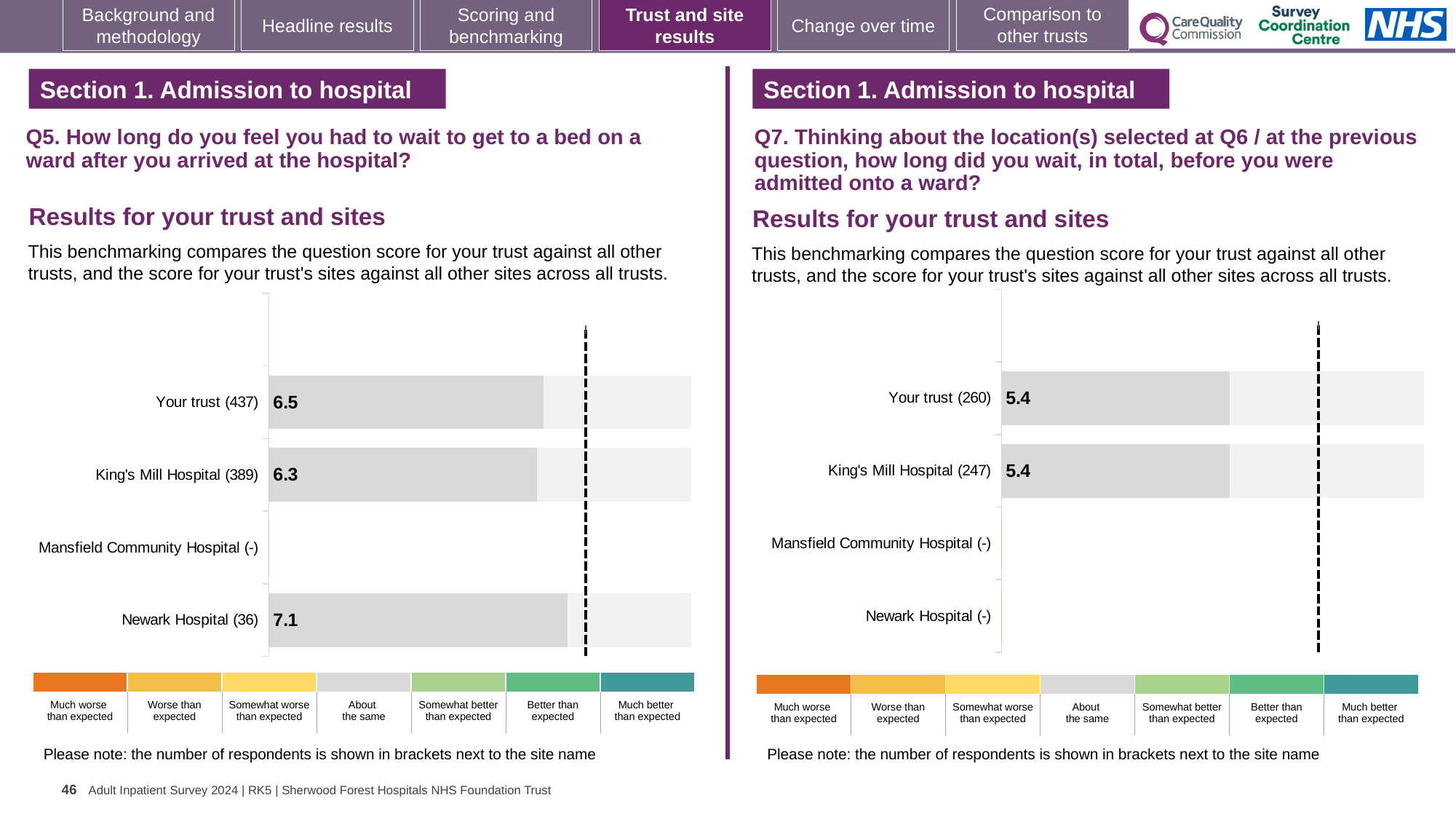
In the Q7 chart on the right, what is the score for King's Mill Hospital? 5.4 How many site/trust rows are listed in the Q7 chart on the right? 4 In the Q5 chart on the left, what is the score for Newark Hospital? 7.1 In the Q5 chart on the left, what is the difference between the Newark Hospital score and the King's Mill Hospital score? 0.8 In the Q5 chart on the left, how many respondents are shown for Newark Hospital? 36 What type of chart is used in the Q5 chart on the left? Bar chart In the Q5 chart on the left, which is larger: the score for Your trust or the score for King's Mill Hospital? Your trust In the Q7 chart on the right, what is the score for Your trust? 5.4 In the Q5 chart on the left, what is the score for King's Mill Hospital? 6.3 In the Q7 chart on the right, how many respondents are shown for King's Mill Hospital? 247 In the Q5 chart on the left, which site has the highest score? Newark Hospital In the Q5 chart on the left, what is the score for Your trust? 6.5